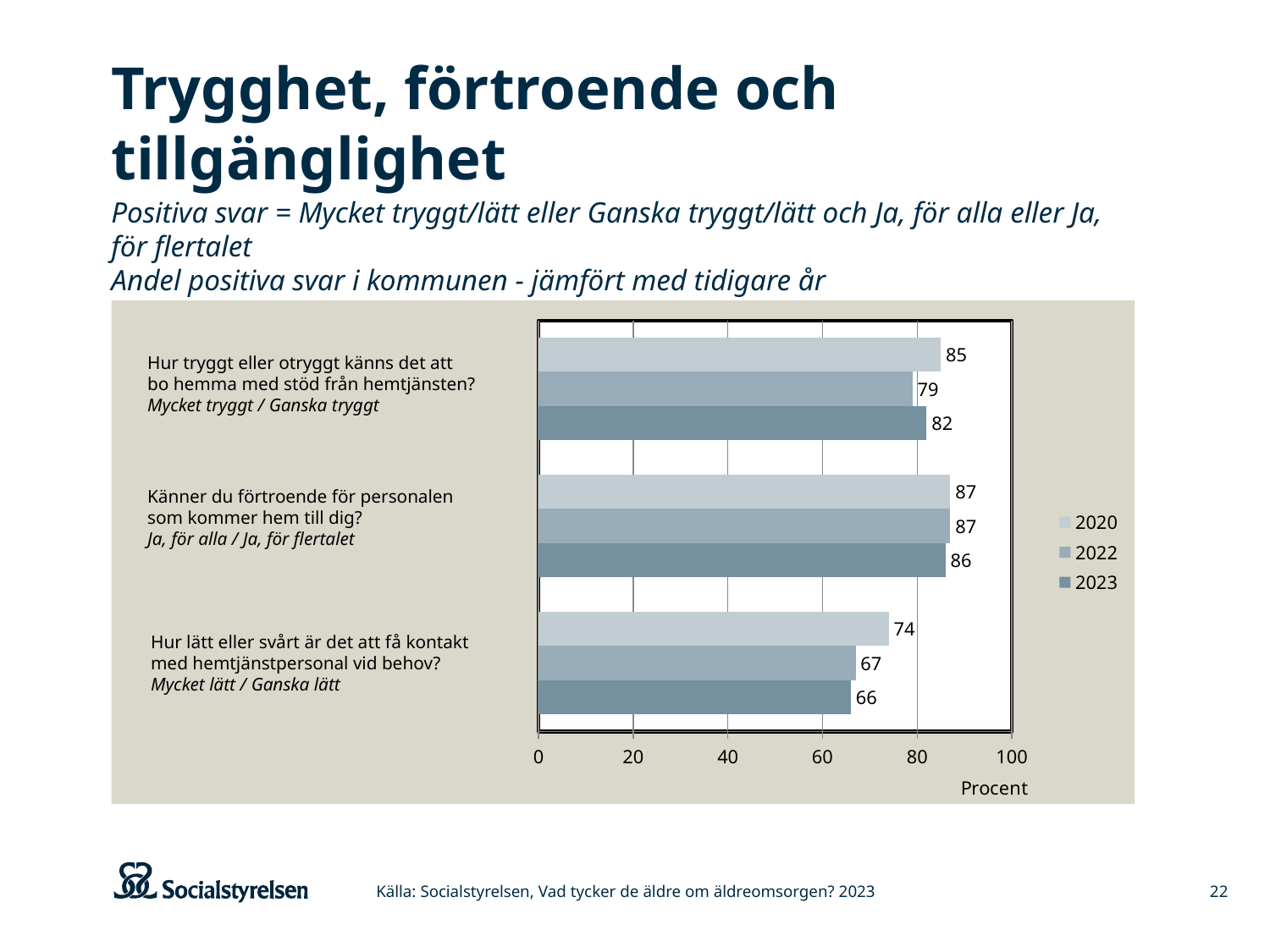
For "Hur lätt eller svårt är det att få kontakt med hemtjänstpersonal vid behov?", which is larger: the 2020 value or the 2023 value? 2020 What is the 2020 value for "Hur tryggt eller otryggt känns det att bo hemma med stöd från hemtjänsten?"? 85 What is the 2022 value for "Hur lätt eller svårt är det att få kontakt med hemtjänstpersonal vid behov?"? 67 Which question has the highest 2020 value? Känner du förtroende för personalen som kommer hem till dig? What is the difference between the 2020 and 2022 values for "Hur tryggt eller otryggt känns det att bo hemma med stöd från hemtjänsten?"? 6 What is the 2023 value for "Känner du förtroende för personalen som kommer hem till dig?"? 86 Is the 2023 value for "Hur lätt eller svårt är det att få kontakt med hemtjänstpersonal vid behov?" greater or less than 80? less What label is shown on the horizontal axis of the chart? Procent How many series does the legend list? 3 Which question has the lowest 2023 value? Hur lätt eller svårt är det att få kontakt med hemtjänstpersonal vid behov? How many question categories are plotted on the chart? 3 What kind of chart is shown on the slide? bar chart